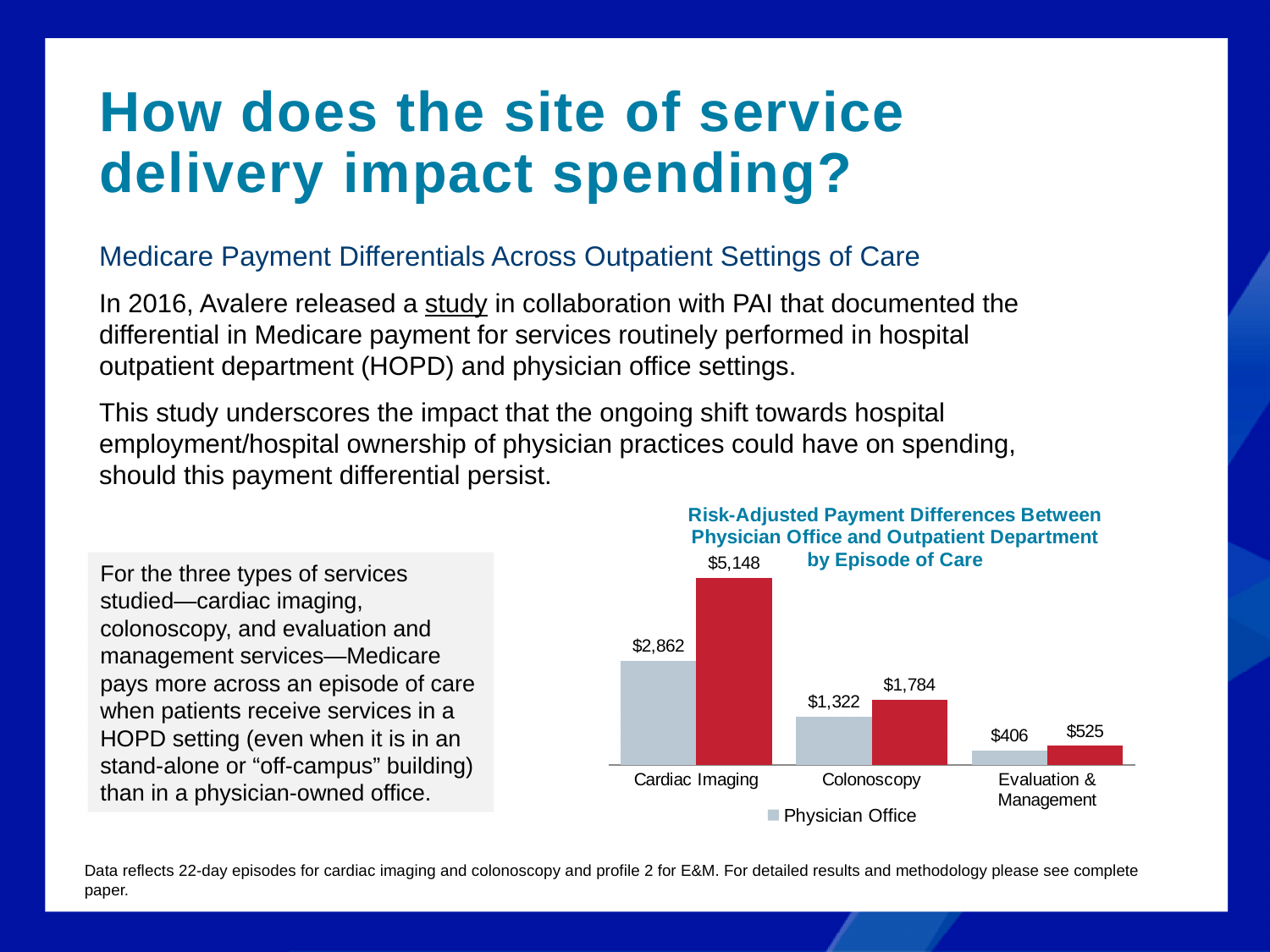
Which is larger for Evaluation & Management: the Physician Office bar or the red bar? The red bar How many episode-of-care categories are shown on the x axis of the chart? 3 What is the title of the chart? Risk-Adjusted Payment Differences Between Physician Office and Outpatient Department by Episode of Care What is the Physician Office value for Cardiac Imaging? $2,862 Which category has the lowest Physician Office value? Evaluation & Management What is the difference between the red bar and the Physician Office bar for Colonoscopy? $462 What is the Physician Office value for Colonoscopy? $1,322 What is the value of the red bar for Cardiac Imaging? $5,148 What type of chart is shown on the slide? Bar chart What is the difference between the red bar and the Physician Office bar for Cardiac Imaging? $2,286 Which category has the highest Physician Office value? Cardiac Imaging What is the value of the red bar for Evaluation & Management? $525